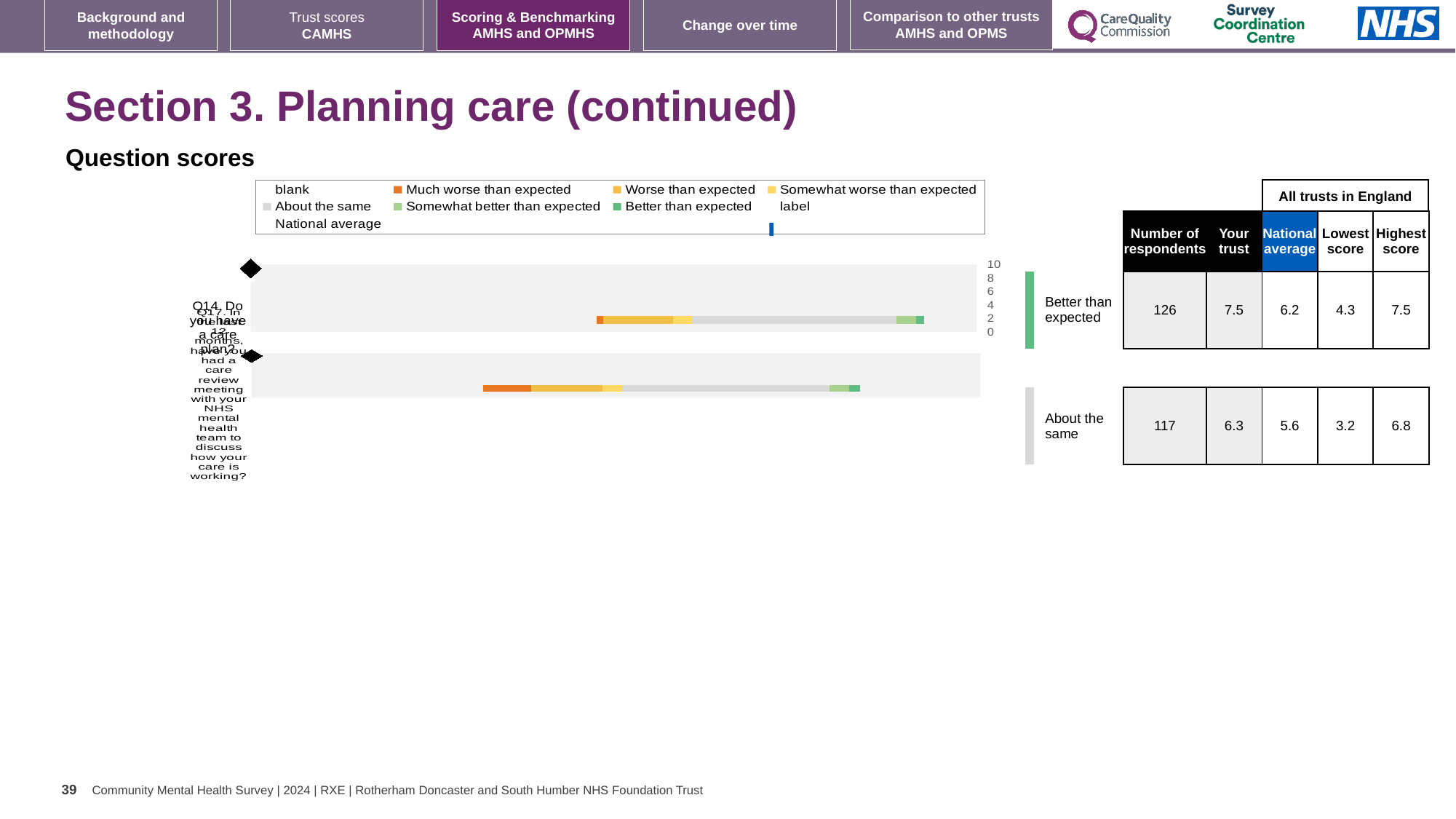
What is the difference between the 'Your trust' score and the national average for Q14? 1.3 Which question has the higher 'Your trust' score, Q14 or Q17? Q14 Which benchmark category is shown for Q14? Better than expected What is the highest score across all trusts in England for Q17? 6.8 How many question bars are plotted in the chart? 2 What is the 'Your trust' score for Q14 (Do you have a care plan?)? 7.5 What is the difference between the highest and lowest scores for Q17? 3.6 Which question has more respondents, Q14 or Q17? Q14 What is the national average score for Q17 (care review meeting in the last 12 months)? 5.6 Which benchmark category is shown for Q17? About the same How many respondents answered Q14? 126 What kind of chart is shown under 'Question scores'? bar chart